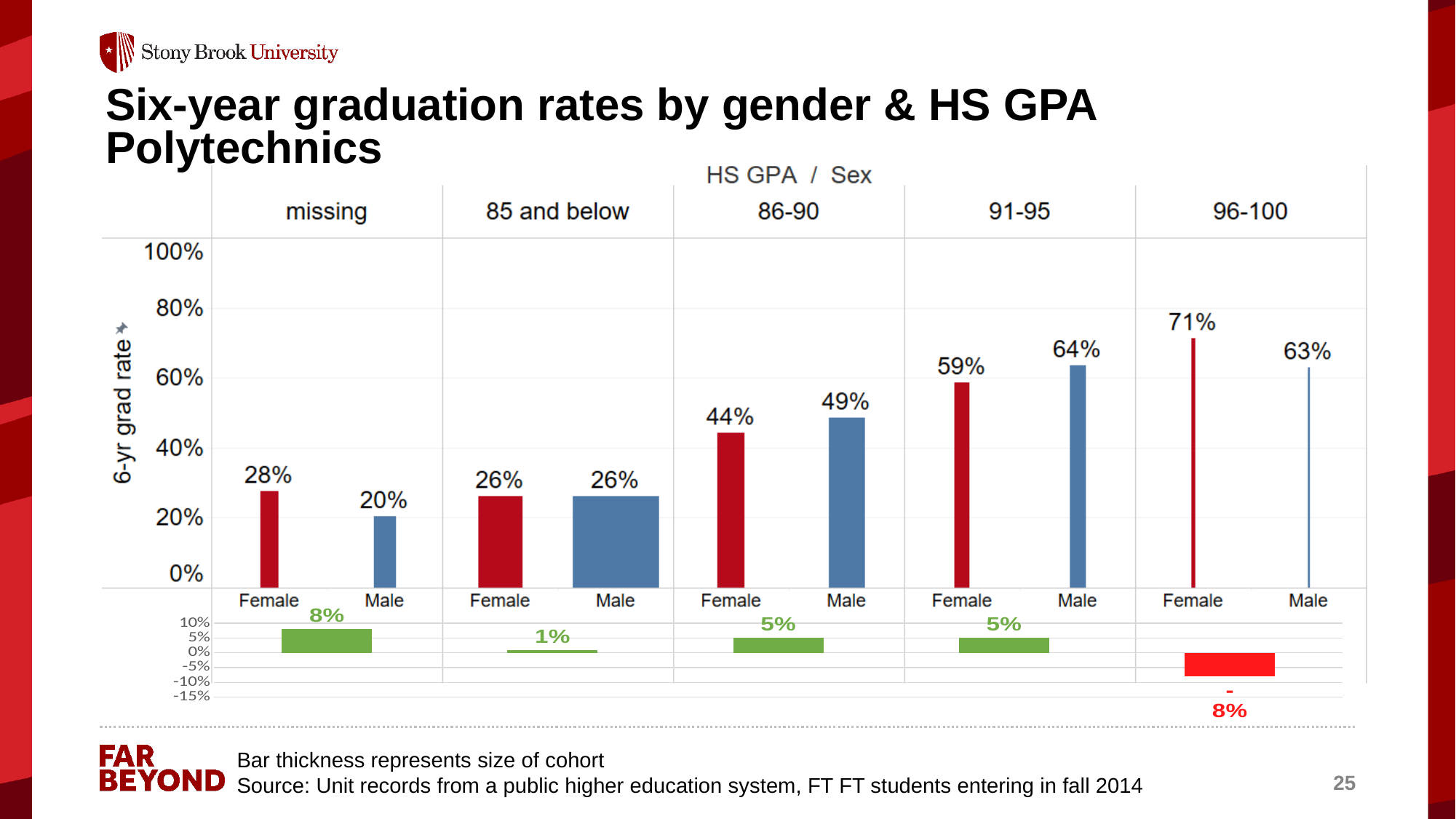
In the main graduation-rate chart, do the Female graduation rates rise or fall as HS GPA increases from '85 and below' to '96-100'? Rise In the main graduation-rate chart, what is the difference between the Male and Female graduation rates in the 91-95 HS GPA group? 5% In the main graduation-rate chart, which bar has the highest six-year graduation rate? Female, 96-100 In the main graduation-rate chart, what is the six-year graduation rate for Female students with HS GPA 96-100? 71% In the main graduation-rate chart, how many HS GPA groups are shown? 5 In the small difference chart below the main chart, what value is shown for the 96-100 HS GPA group? -8% In the main graduation-rate chart, which bar has the lowest six-year graduation rate? Male, missing According to the note on the slide, what does bar thickness represent in the main chart? Size of cohort In the main graduation-rate chart, what is the six-year graduation rate for Male students with HS GPA 86-90? 49% In the main graduation-rate chart, what is the six-year graduation rate for Male students with missing HS GPA? 20% In the main graduation-rate chart, which is larger: the Female rate or the Male rate in the 86-90 HS GPA group? Male What type of chart is the main graduation-rate chart? Bar chart